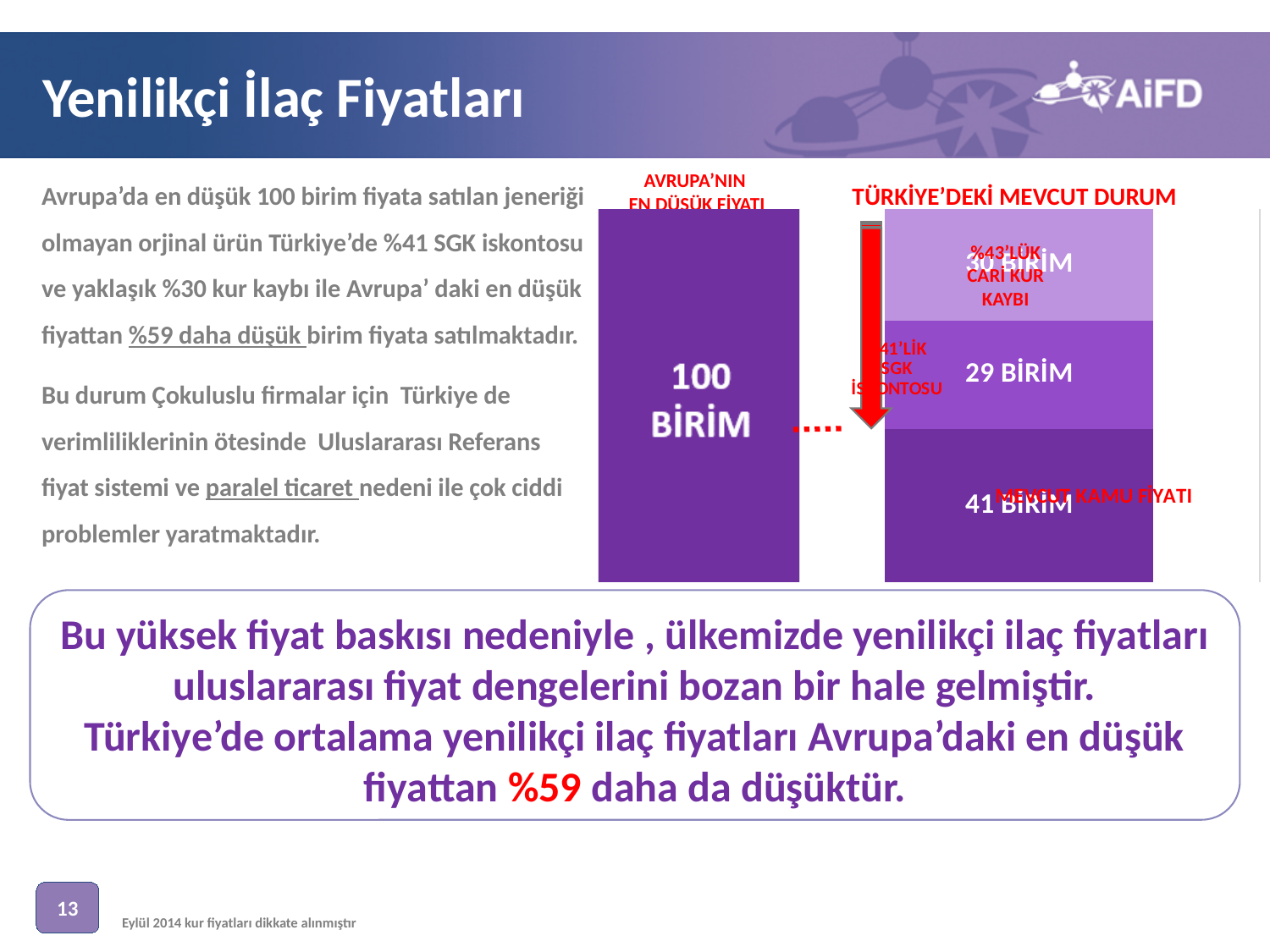
What is the value shown for the bar labelled AVRUPA'NIN EN DÜŞÜK FİYATI? 100 BİRİM Which is larger, the 30 BİRİM segment or the 41 BİRİM segment? 41 BİRİM Which segment of the TÜRKİYE'DEKİ MEVCUT DURUM bar is the largest? 41 BİRİM (MEVCUT KAMU FİYATI) What is the value of the bottom segment (MEVCUT KAMU FİYATI) of the TÜRKİYE'DEKİ MEVCUT DURUM bar? 41 BİRİM How many segments make up the TÜRKİYE'DEKİ MEVCUT DURUM stacked bar? 3 What percentage SGK discount is labelled on the red arrow between the two bars? %41 What kind of chart is shown on the slide? bar chart What is the value of the top segment of the TÜRKİYE'DEKİ MEVCUT DURUM bar? 30 BİRİM What is the difference between the 41 BİRİM segment and the 29 BİRİM segment? 12 BİRİM What is the total of the three segments in the TÜRKİYE'DEKİ MEVCUT DURUM stacked bar? 100 BİRİM Which segment of the TÜRKİYE'DEKİ MEVCUT DURUM bar is the smallest? 29 BİRİM What is the value of the middle segment of the TÜRKİYE'DEKİ MEVCUT DURUM bar? 29 BİRİM